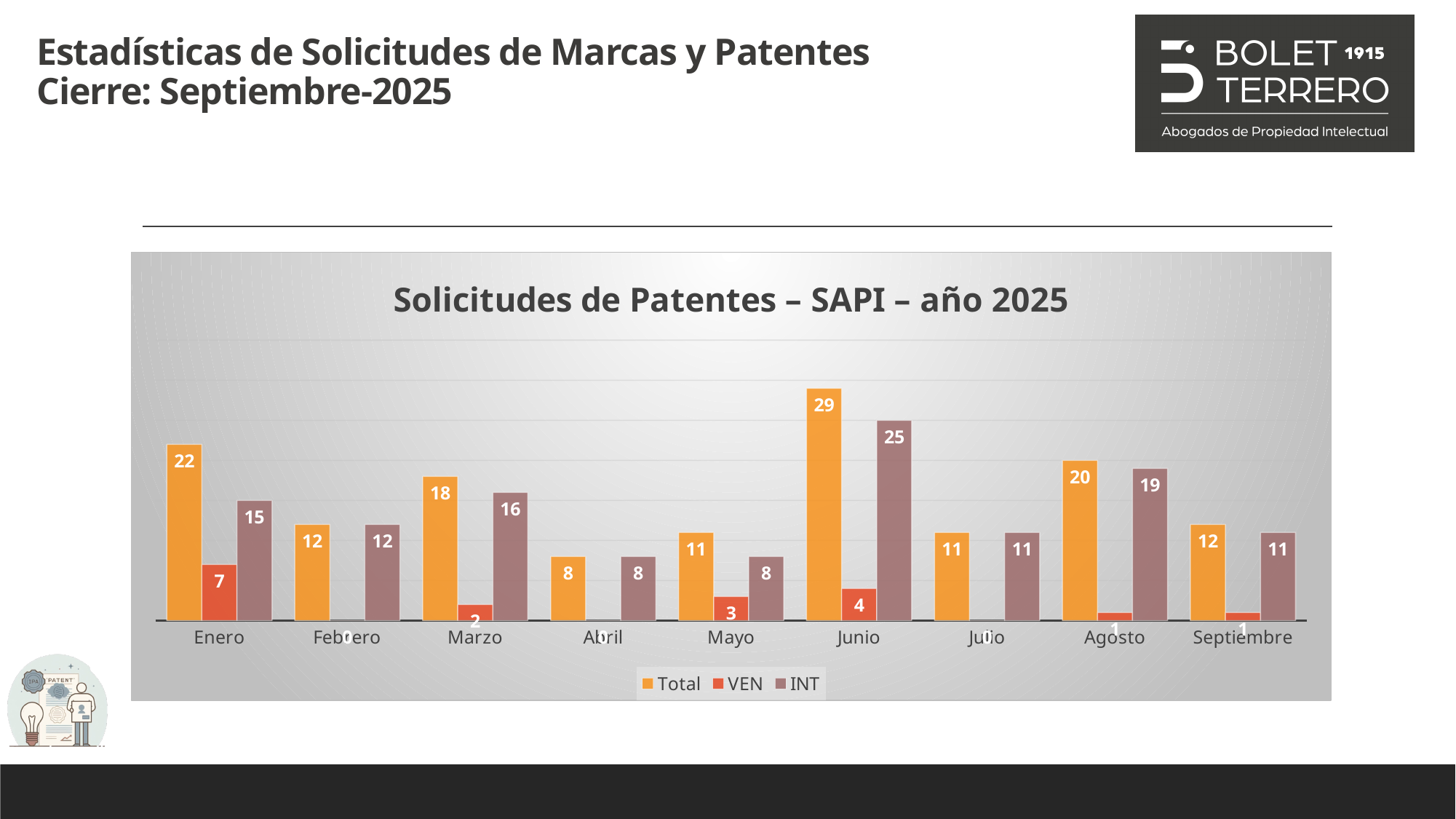
Which month has the highest Total value? Junio What kind of chart is shown? Bar chart What is the INT value for Agosto? 19 How many series does the legend list? 3 Which is larger, the INT value for Marzo or the INT value for Enero? Marzo What is the title of the chart? Solicitudes de Patentes – SAPI – año 2025 How many months are shown on the x axis? 9 What is the VEN value for Enero? 7 What is the Total value for Junio? 29 What is the difference between the Total values for Junio and Enero? 7 Which month has the lowest Total value? Abril What is the difference between the Total and INT values for Mayo? 3